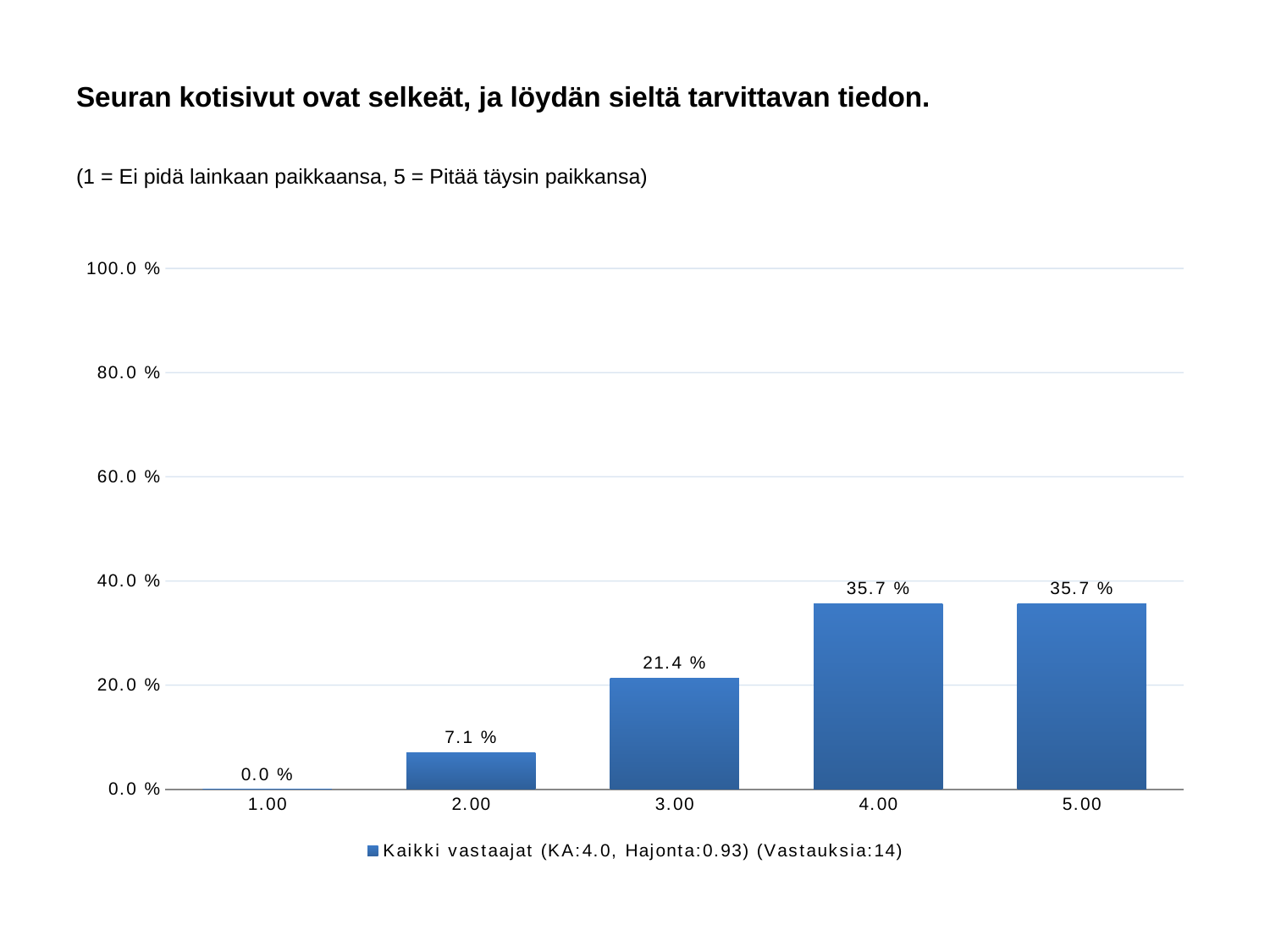
What is the difference between the values for 4.00 and 3.00? 14.3 % What is the value for category 1.00? 0.0 % Is the value for 4.00 greater or less than 40.0 %? less How many categories are shown on the x axis? 5 What is the value for category 5.00? 35.7 % What is the value for category 3.00? 21.4 % What is the difference between the values for 3.00 and 2.00? 14.3 % Which is larger, the value for 3.00 or the value for 2.00? 3.00 What kind of chart is shown on the slide? bar chart How many responses (Vastauksia) does the legend report? 14 Which category has the lowest value? 1.00 What is the value for category 2.00? 7.1 %